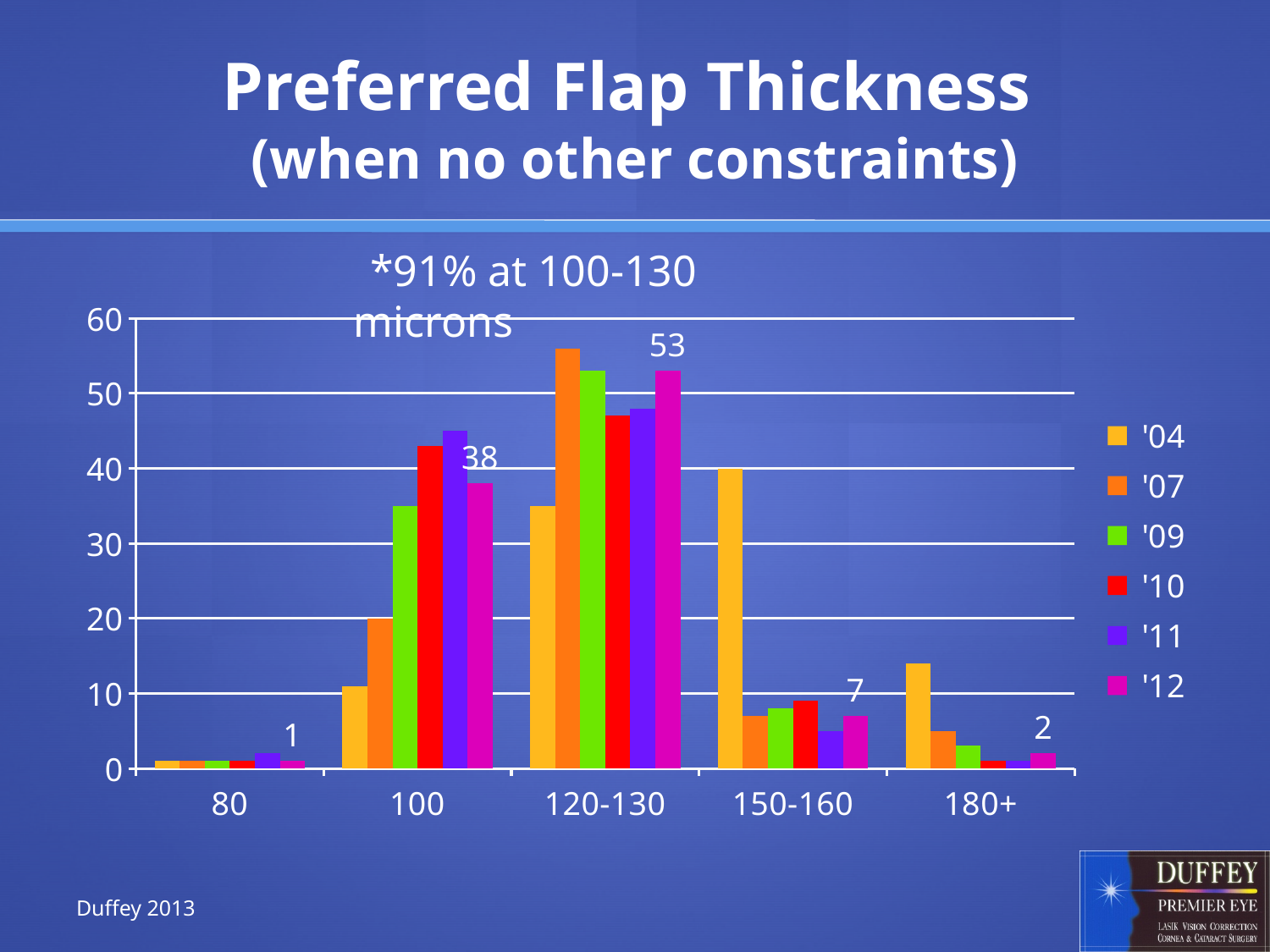
Is the value for '04 at 150-160 greater or less than 30? greater Which category has the highest value for the '12 series? 120-130 Which is larger for the '12 series: the value at 100 or at 120-130? 120-130 How many series does the legend list? 6 What is the value for '12 at 180+? 2 What is the difference between the '12 values at 120-130 and 100? 15 How many categories are shown on the x axis? 5 What is the value for '12 at 150-160? 7 What is the value for '12 at 120-130? 53 Which category has the lowest value for the '12 series? 80 What kind of chart is shown on the slide? bar chart What is the value for '12 at 100? 38